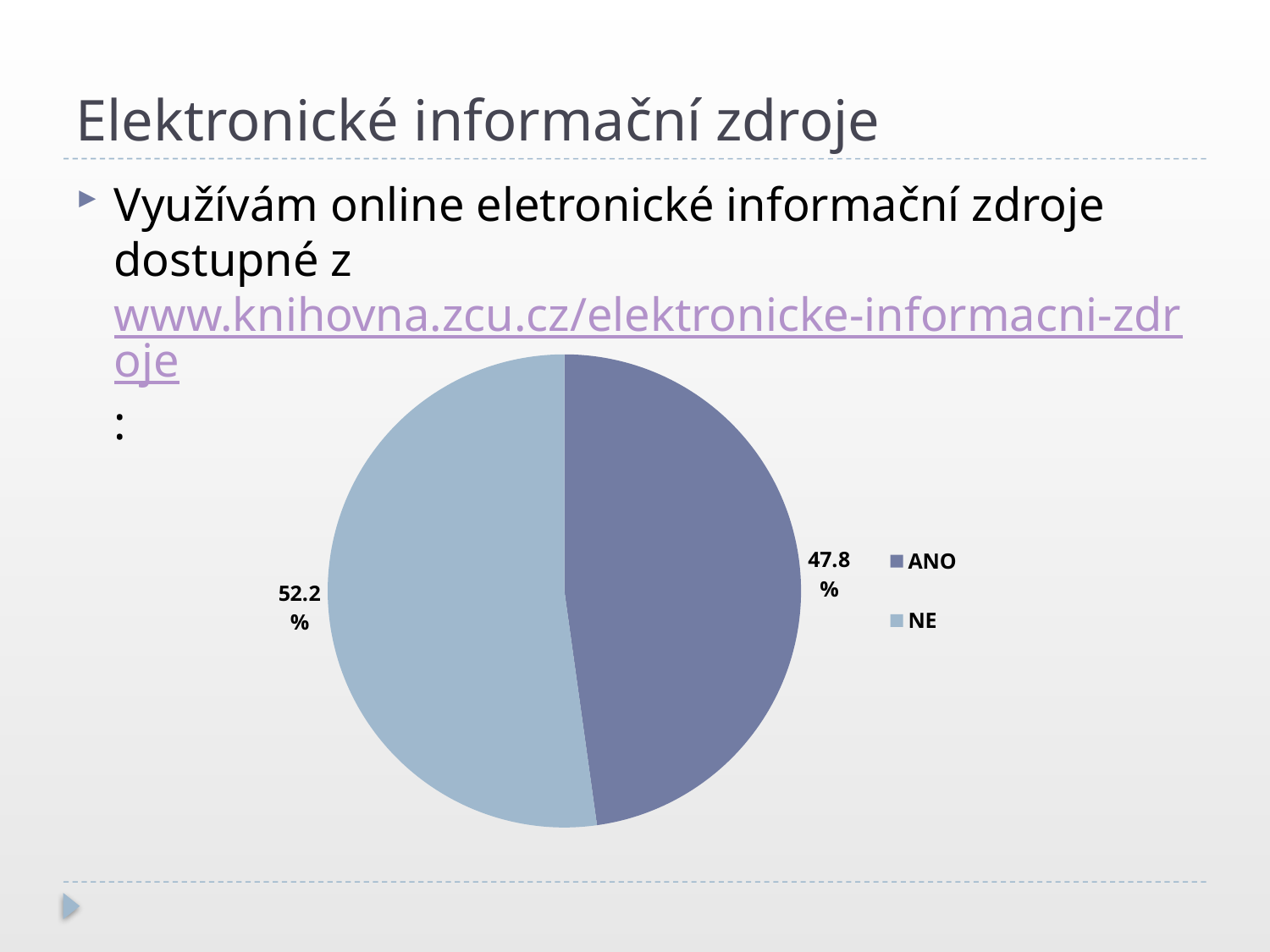
How many slices does the pie chart have? 2 Which is larger, the share for ANO or the share for NE? NE Which category has the smallest share of the pie? ANO What is the value for NE? 52.2% Which category has the largest share of the pie? NE What kind of chart is shown on the slide? pie chart What is the difference between the NE and ANO shares? 4.4% What is the value for ANO? 47.8% What is the title of the slide containing the chart? Elektronické informační zdroje What share of the pie does the NE slice represent? 52.2% How many entries does the legend list? 2 Which legend entry is shown in the darker blue colour? ANO